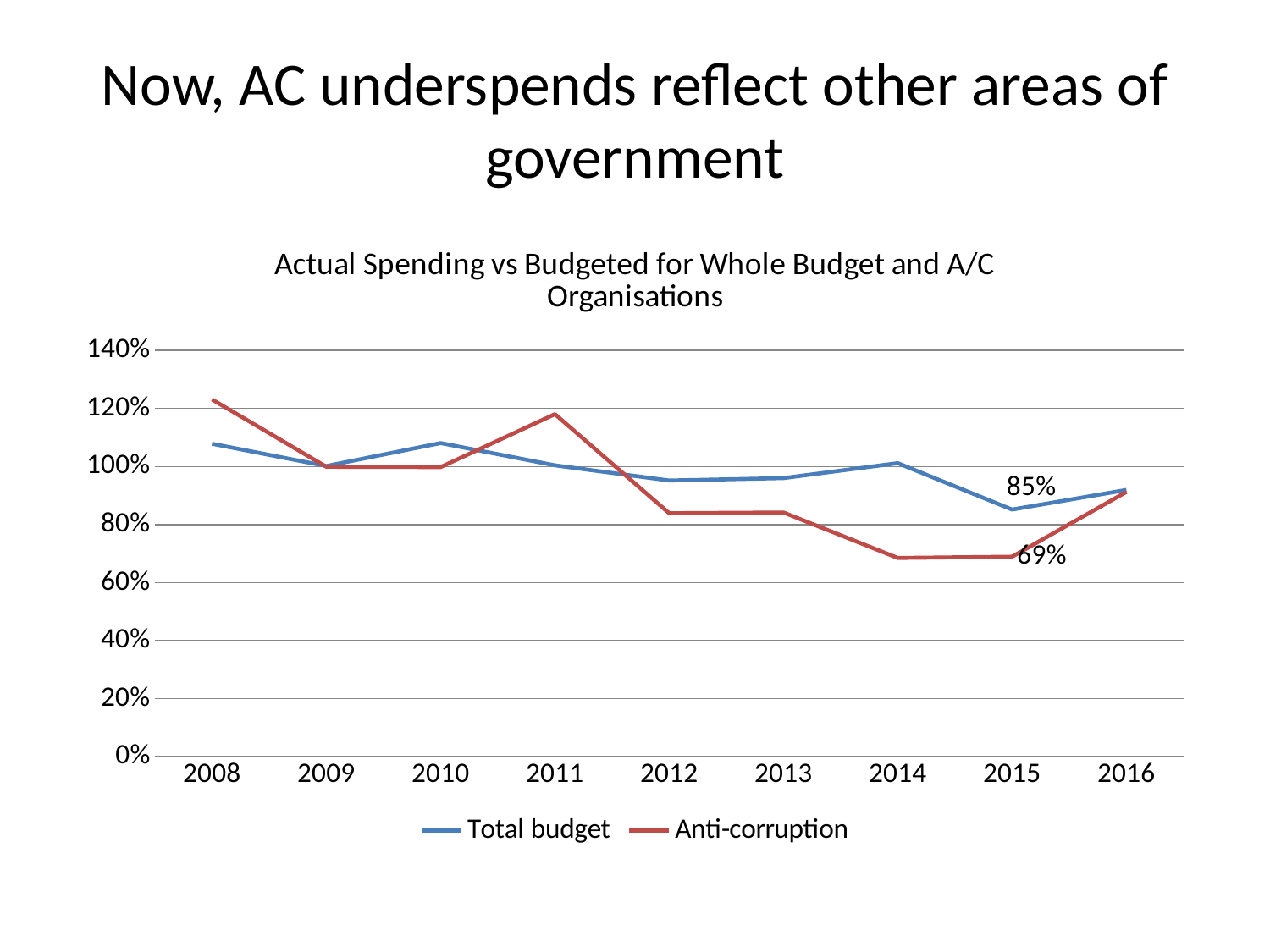
In 2015, which series has the larger value, Total budget or Anti-corruption? Total budget What kind of chart is shown on the slide? Line chart In which year is the Anti-corruption series at its highest? 2008 In which year is the Total budget series at its lowest? 2015 What is the difference between the Total budget and Anti-corruption values in 2015? 16 percentage points Is the Anti-corruption value for 2014 greater or less than 80%? less What is the Anti-corruption value for 2015? 69% Is the Total budget value for 2010 greater or less than 100%? greater What is the Total budget value for 2015? 85% How many series does the legend list? 2 Does the Anti-corruption series rise or fall from 2011 to 2014? Fall How many years are plotted along the x axis? 9